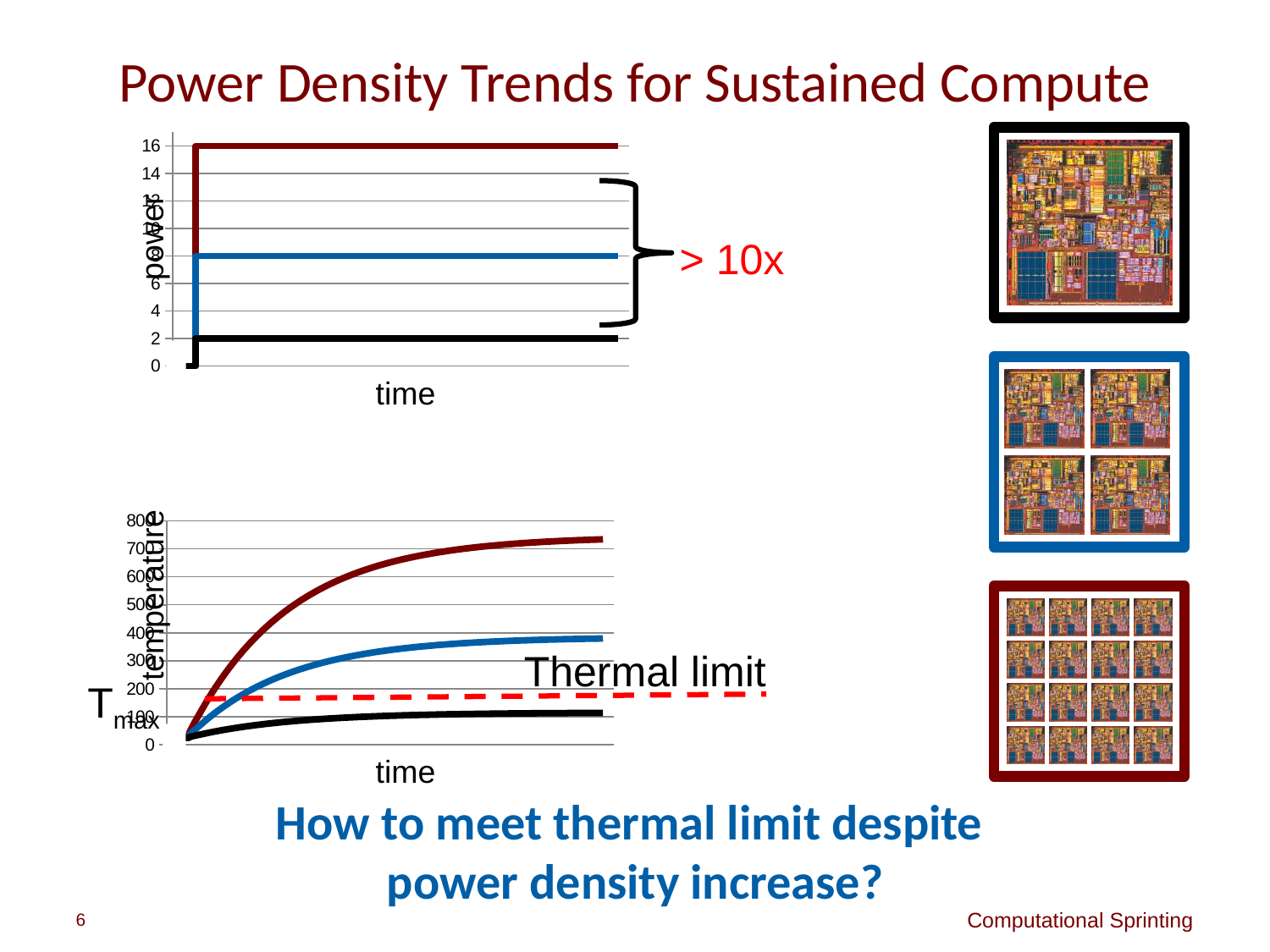
In the bottom temperature chart, is the final value of the black curve greater or less than 200? less In the top power chart, what power value does the dark red line hold after its initial step? 16 In the top power chart, what power value does the blue line hold after its initial step? 8 How many lines are plotted in the top power chart? 3 In the top power chart, what power value does the black line hold after its initial step? 2 In the bottom temperature chart, is the final value of the dark red curve greater or less than 600? greater In the top power chart, what is the difference between the dark red line's power level and the blue line's power level? 8 In the bottom temperature chart, which coloured curve reaches the highest temperature? dark red In the top power chart, which coloured line has the highest power level? dark red In the bottom temperature chart, do the three solid curves rise or fall over time? rise What kind of chart is the top chart (power vs time)? line chart In the bottom temperature chart, what label is given to the dashed red horizontal line? Thermal limit